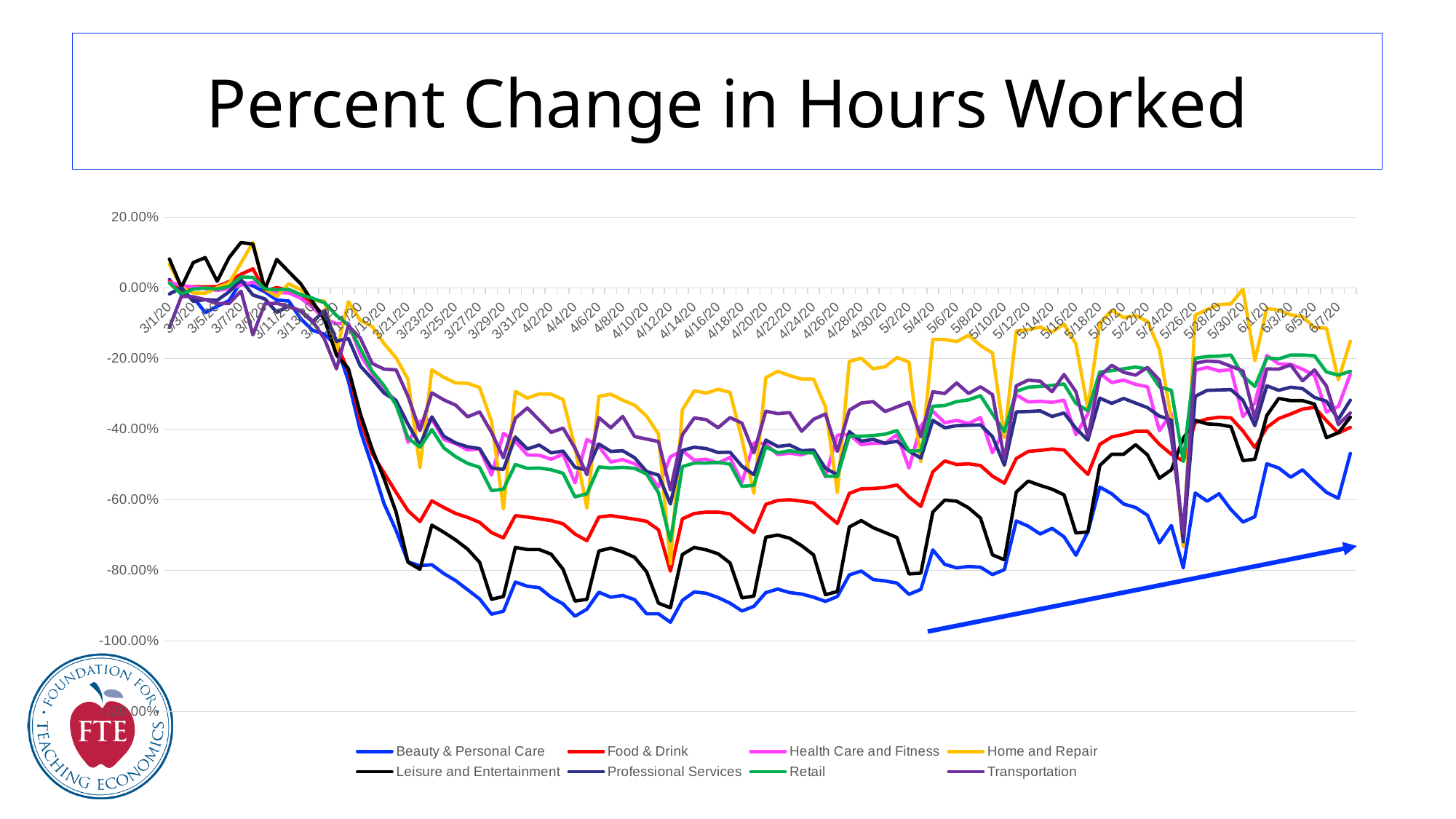
Which series has the highest values during May 2020? Home and Repair Which series is plotted with the blue line? Beauty & Personal Care Is the value for Food & Drink on 4/2/20 greater or less than -60.00%? less From mid-April to early June, do the values for Beauty & Personal Care generally rise or fall? rise Which series has the higher value on 4/20/20, Food & Drink or Leisure and Entertainment? Food & Drink Is the value for Home and Repair on 5/12/20 greater or less than -20.00%? greater What is the title of the chart? Percent Change in Hours Worked Which series has the lowest values during April 2020? Beauty & Personal Care From early March to late March, do the values for Leisure and Entertainment rise or fall? fall What kind of chart is shown on the slide? line chart How many series does the legend list? 8 Is the value for Beauty & Personal Care on 4/12/20 greater or less than -80.00%? less